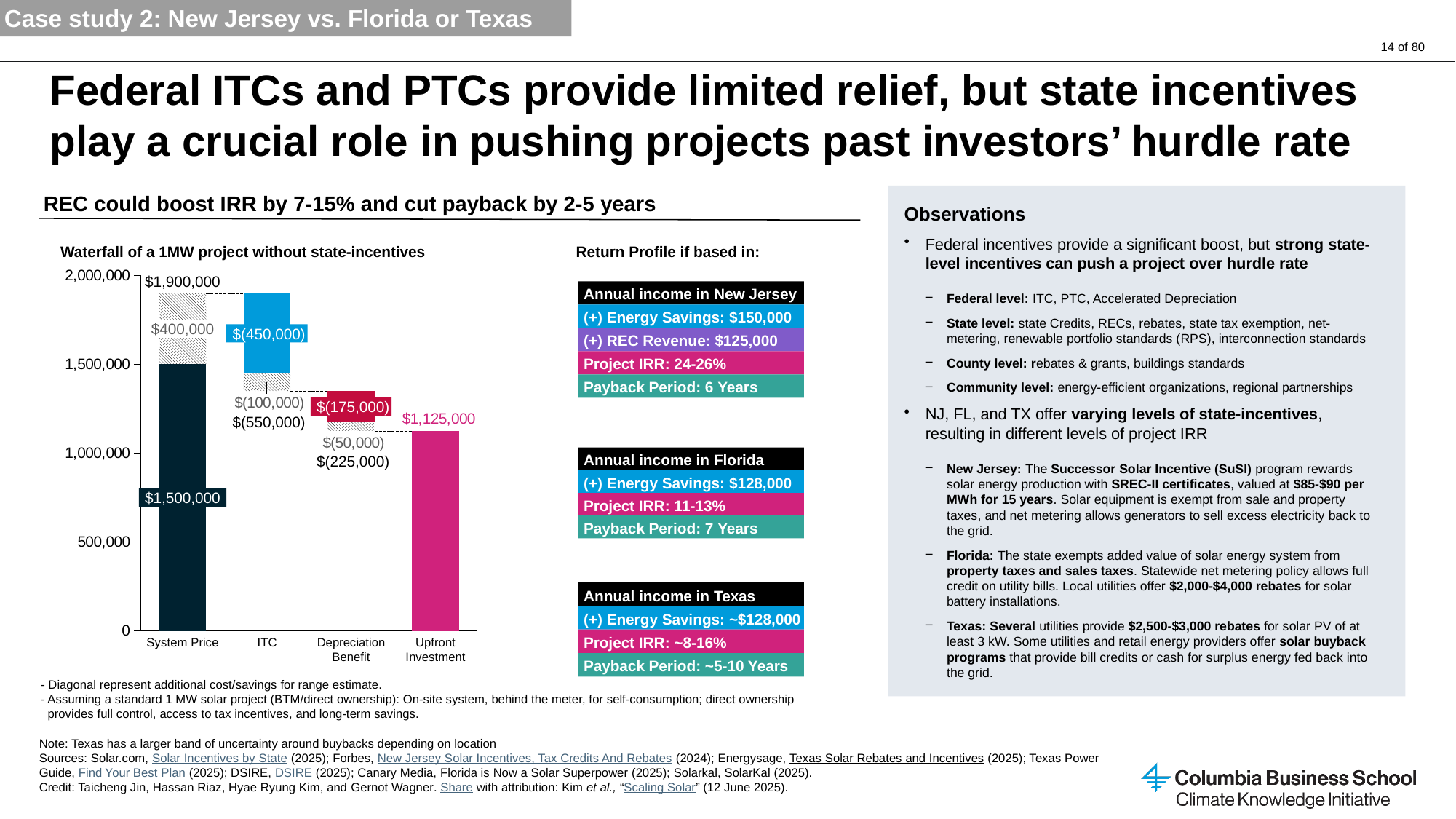
In the waterfall chart, what value is labelled on the solid Depreciation Benefit bar? $(175,000) In the waterfall chart, what is the difference between the System Price ($1,500,000) and the Upfront Investment ($1,125,000)? $375,000 How many categories are shown on the x axis of the waterfall chart? 4 In the waterfall chart, what is the combined ITC reduction including the hatched range estimate? $(550,000) In the waterfall chart, what is the value labelled on the Upfront Investment bar? $1,125,000 What is the title of the chart on the left of the slide? Waterfall of a 1MW project without state-incentives In the waterfall chart, what value is labelled on the solid ITC bar? $(450,000) In the waterfall chart, is the Upfront Investment bar greater or less than 1,000,000? greater In the waterfall chart, what value is labelled at the top of the hatched range above the System Price bar? $1,900,000 What kind of chart is shown on the left of the slide? Bar chart (waterfall) In the waterfall chart, what is the combined Depreciation Benefit reduction including the hatched range estimate? $(225,000) In the waterfall chart, what is the value labelled on the System Price bar? $1,500,000